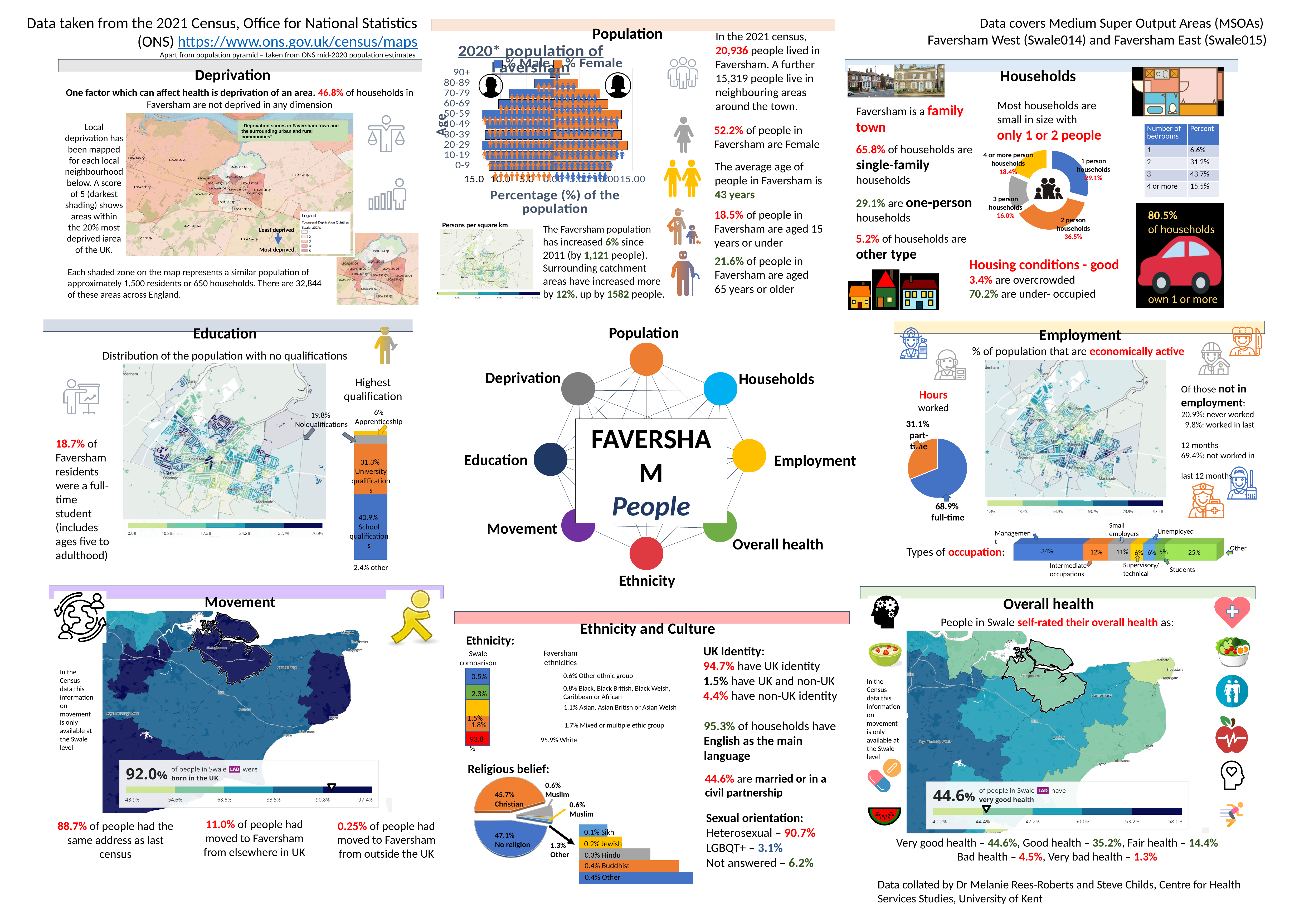
In the Religious belief pie chart, what percentage have No religion? 47.1% In the Hours worked pie chart under Employment, what percentage of people work full-time? 68.9% In the Households donut chart, what is the difference between the share of 1 person households and 3 person households? 13.1% What kind of chart is the 2020* population of Faversham chart showing age groups by % Male and % Female? bar chart (population pyramid) In the Highest qualification stacked bar under Education, what percentage have University qualifications? 31.3% In the Households donut chart, which household size category has the smallest share? 3 person households In the Types of occupation bar, which occupation type has the smallest share? Students In the Hours worked pie chart, which is larger, part-time or full-time? full-time In the Households donut chart, what percentage of households are 2 person households? 36.5% In the Types of occupation bar under Employment, what percentage is Management? 34% In the Highest qualification stacked bar, what is the difference between School qualifications and University qualifications? 9.6% In the Households donut chart, which household size category has the largest share? 2 person households